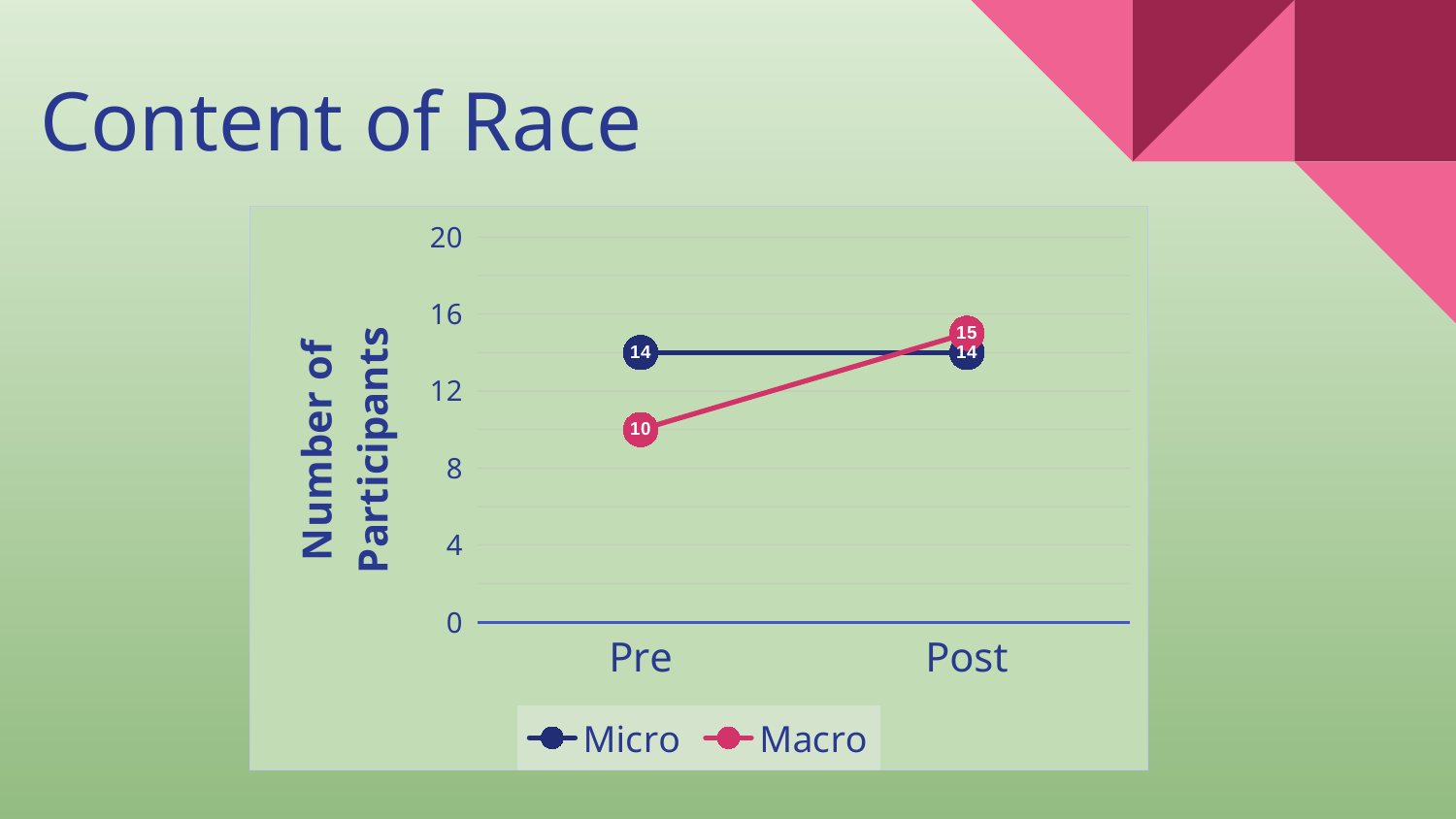
What is the difference between the Macro values at Post and Pre? 5 How many categories are shown on the x axis? 2 What is the y-axis label of the chart? Number of Participants Does the Macro series rise or fall from Pre to Post? rise What is the value for Micro at Post? 14 How many series does the legend list? 2 Which series is drawn in pink? Macro At Pre, which series has the larger value, Micro or Macro? Micro What kind of chart is shown on the slide? line chart What is the value for Macro at Pre? 10 What is the value for Macro at Post? 15 What is the value for Micro at Pre? 14